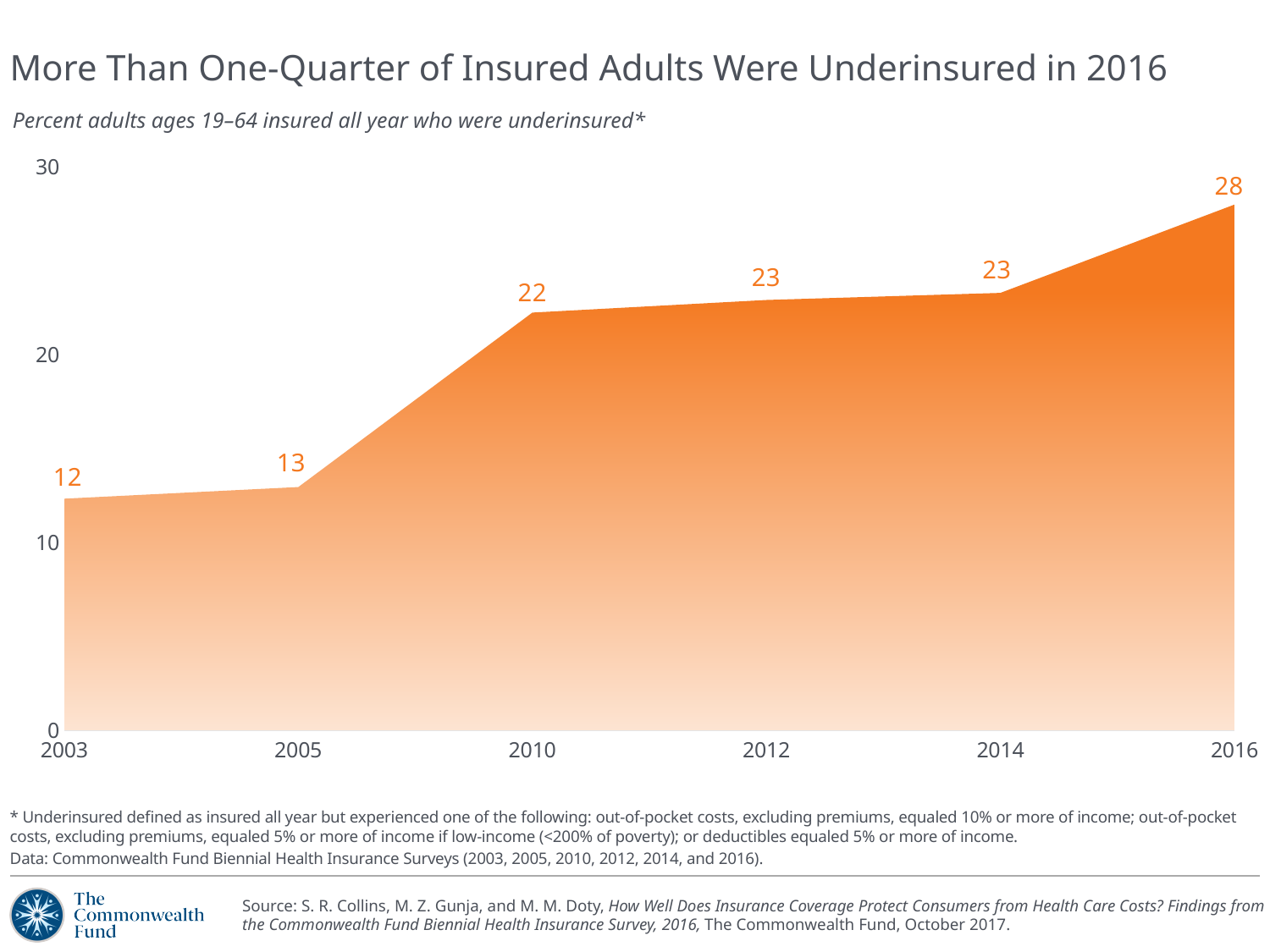
Which year has the highest value? 2016 Do the values rise or fall from 2003 to 2016? Rise Is the value for 2012 greater or less than 20? greater What value is shown for 2003? 12 Which year has the lowest value? 2003 What percent of insured adults were underinsured in 2016? 28 How many years are plotted on the chart? 6 What kind of chart is shown on the slide? Area chart What is the difference between the values for 2016 and 2003? 16 Which is larger, the value for 2005 or the value for 2014? 2014 What value is shown for 2010? 22 What is the difference between the values for 2010 and 2005? 9